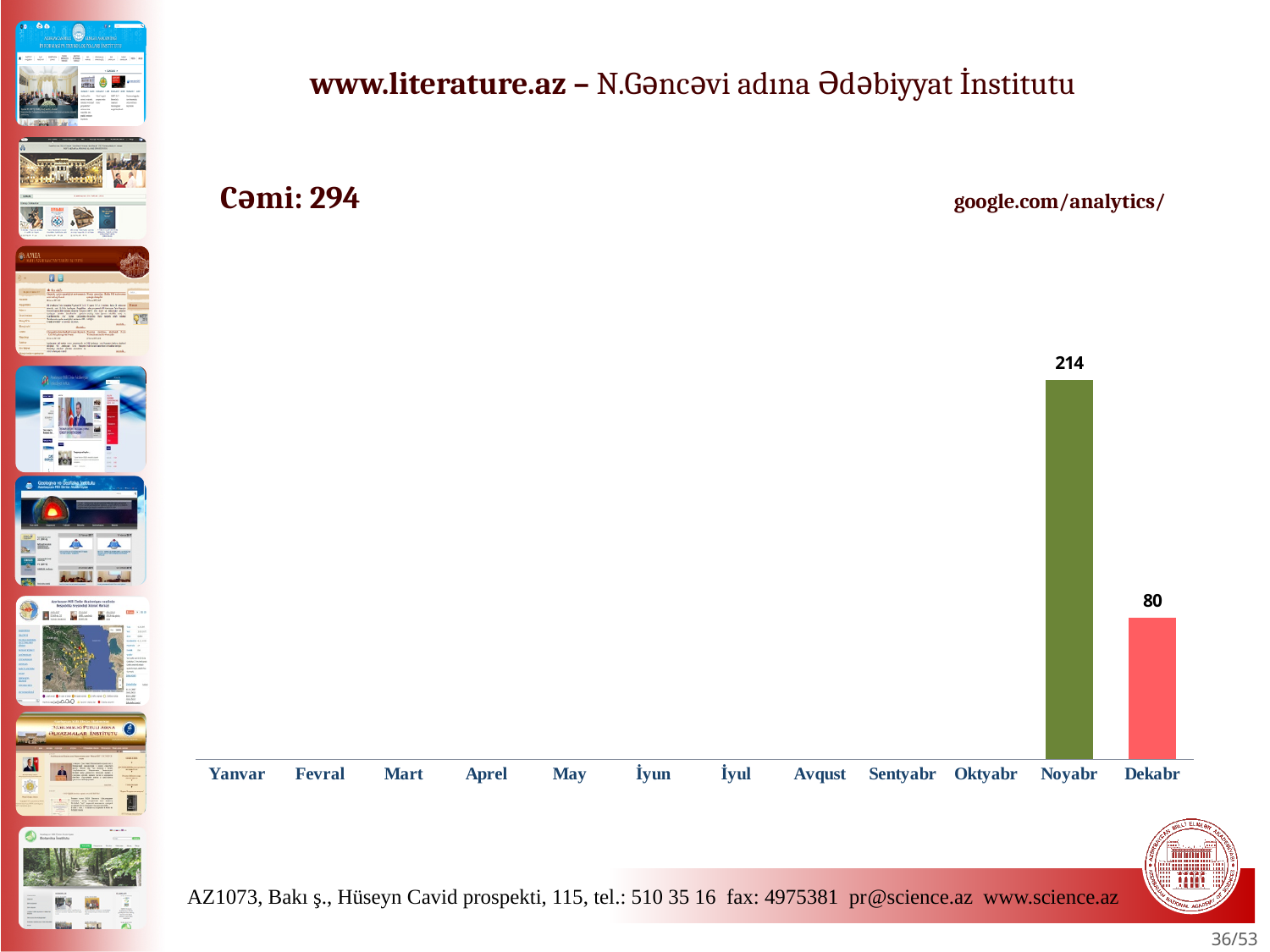
What colour is the bar for Dekabr? red How many month categories are shown on the x axis? 12 What colour is the bar for Noyabr? green Which is larger, the value for Noyabr or the value for Dekabr? Noyabr What kind of chart is shown on the slide? bar chart What is the total (Cəmi) shown on the slide? 294 What is the value for Dekabr? 80 What is the sum of the values for Noyabr and Dekabr? 294 Which month has the highest value? Noyabr How many months have a visible bar in the chart? 2 What is the value for Noyabr? 214 What is the difference between the values for Noyabr and Dekabr? 134